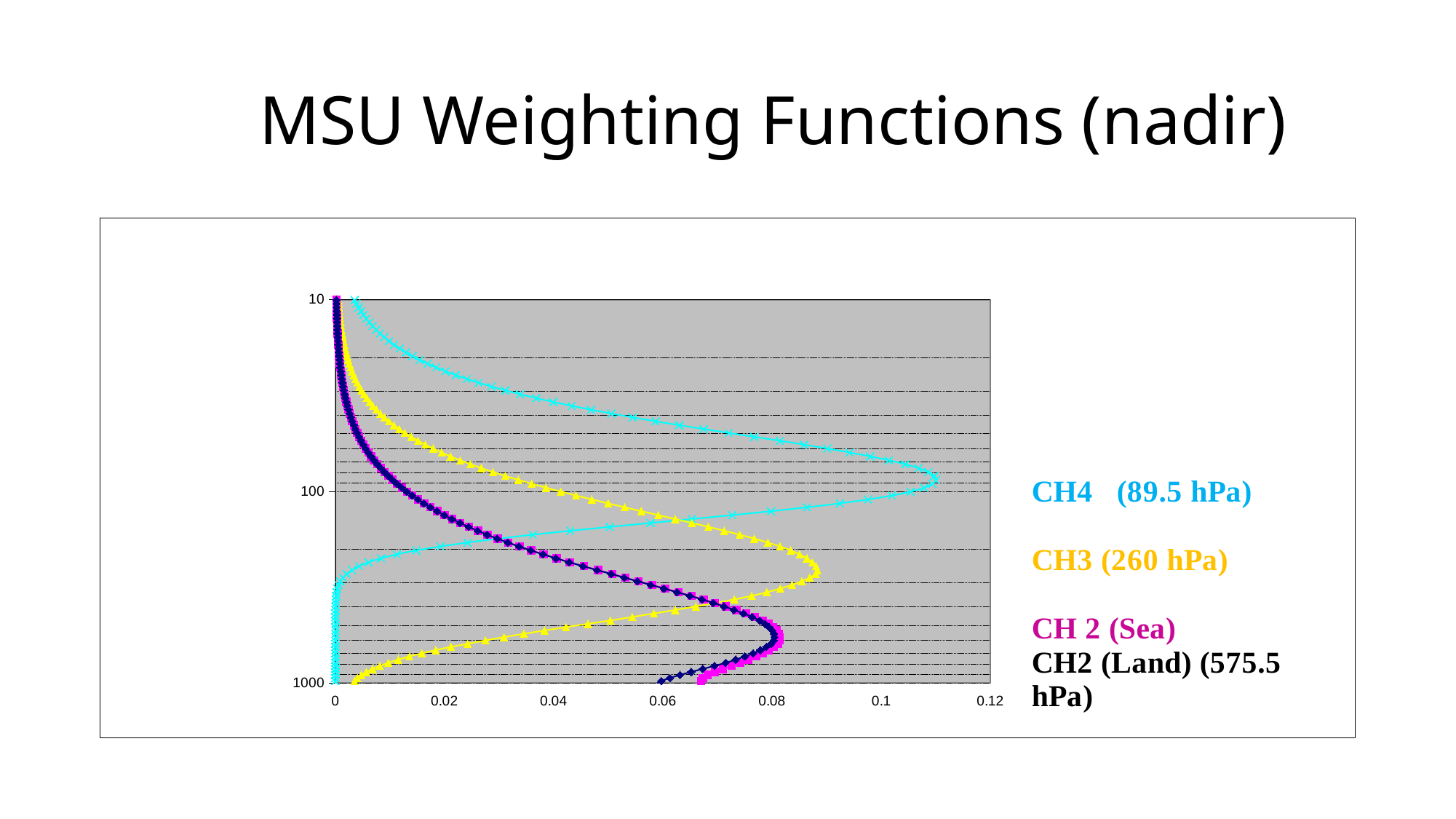
Is the peak value of the CH2 (Land) curve greater or less than 0.1? less Is the peak value of the CH3 curve greater or less than 0.1? less Which series reaches the largest weighting value on the x axis? CH4 What kind of chart is shown on the slide? line chart How many series are listed in the chart's legend? 4 Which curve has the larger peak value, CH3 or CH2 (Sea)? CH3 Is the peak value of the CH3 curve greater or less than 0.08? greater What peak pressure is listed for CH3 in the legend? 260 hPa What is the maximum value shown on the x axis? 0.12 What peak pressure is listed for CH4 in the legend? 89.5 hPa Which curve has the larger peak value, CH4 or CH3? CH4